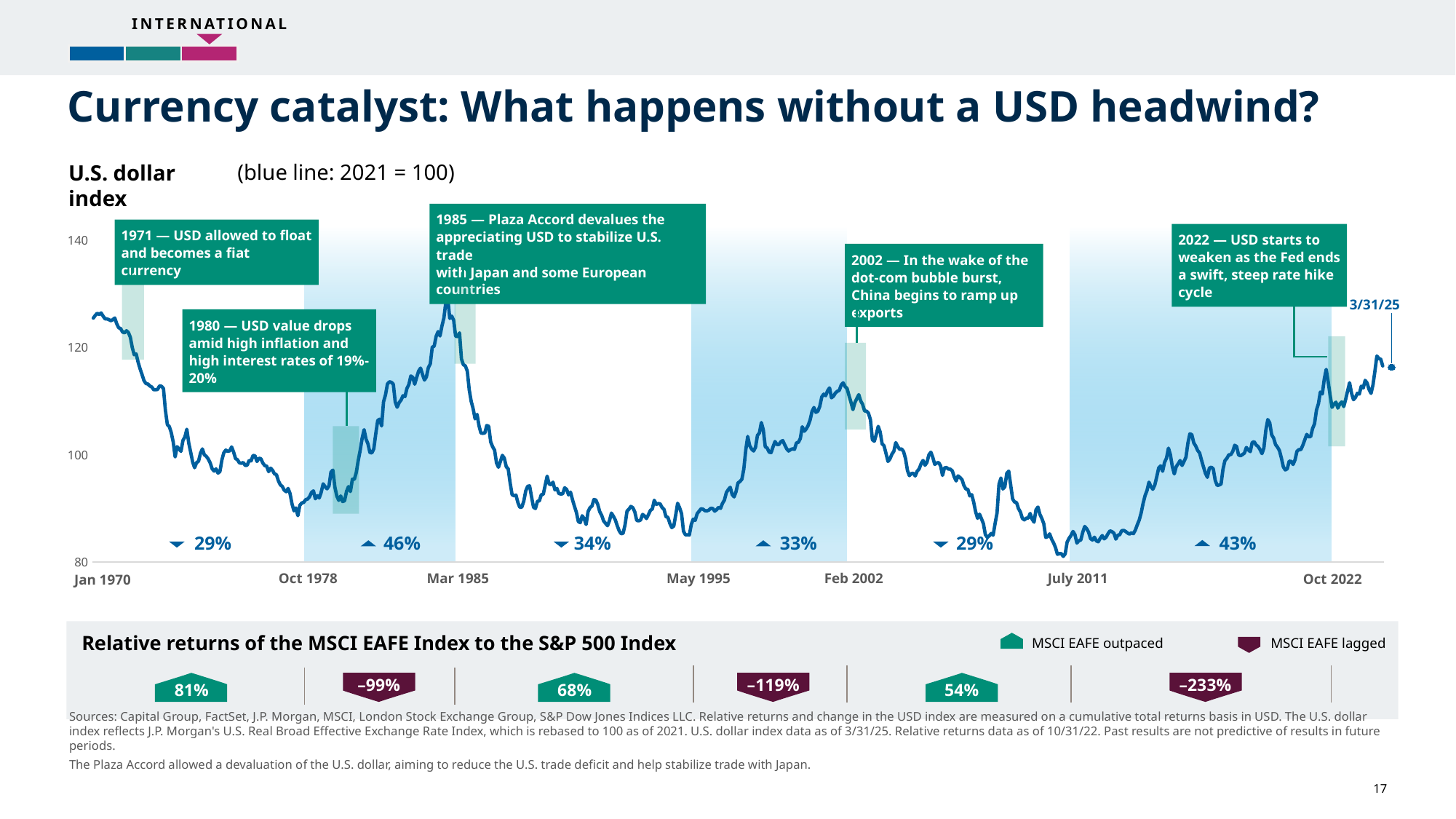
What is the percentage change in the U.S. dollar index shown for the period between Oct 1978 and Mar 1985? 46% Which period has the largest percentage change in the U.S. dollar index? Oct 1978 to Mar 1985 (46%) What kind of chart is used to show the U.S. dollar index? line chart What base year and value is the blue line of the U.S. dollar index rebased to? 2021 = 100 What is the difference between the relative returns of 81% (Jan 1970–Oct 1978) and 68% (Mar 1985–May 1995)? 13 percentage points How many periods of relative returns of the MSCI EAFE Index to the S&P 500 Index are shown? 6 Which period has the lowest relative return of the MSCI EAFE Index to the S&P 500 Index? July 2011 to Oct 2022 (–233%) Is the U.S. dollar index around July 2011 greater or less than 100? less Is the U.S. dollar index at Jan 1970 greater or less than 120? greater What is the percentage change in the U.S. dollar index shown for the period between Feb 2002 and July 2011? 29% What is the relative return of the MSCI EAFE Index to the S&P 500 Index shown for the period between July 2011 and Oct 2022? –233% What is the relative return of the MSCI EAFE Index to the S&P 500 Index shown for the period between Jan 1970 and Oct 1978? 81%